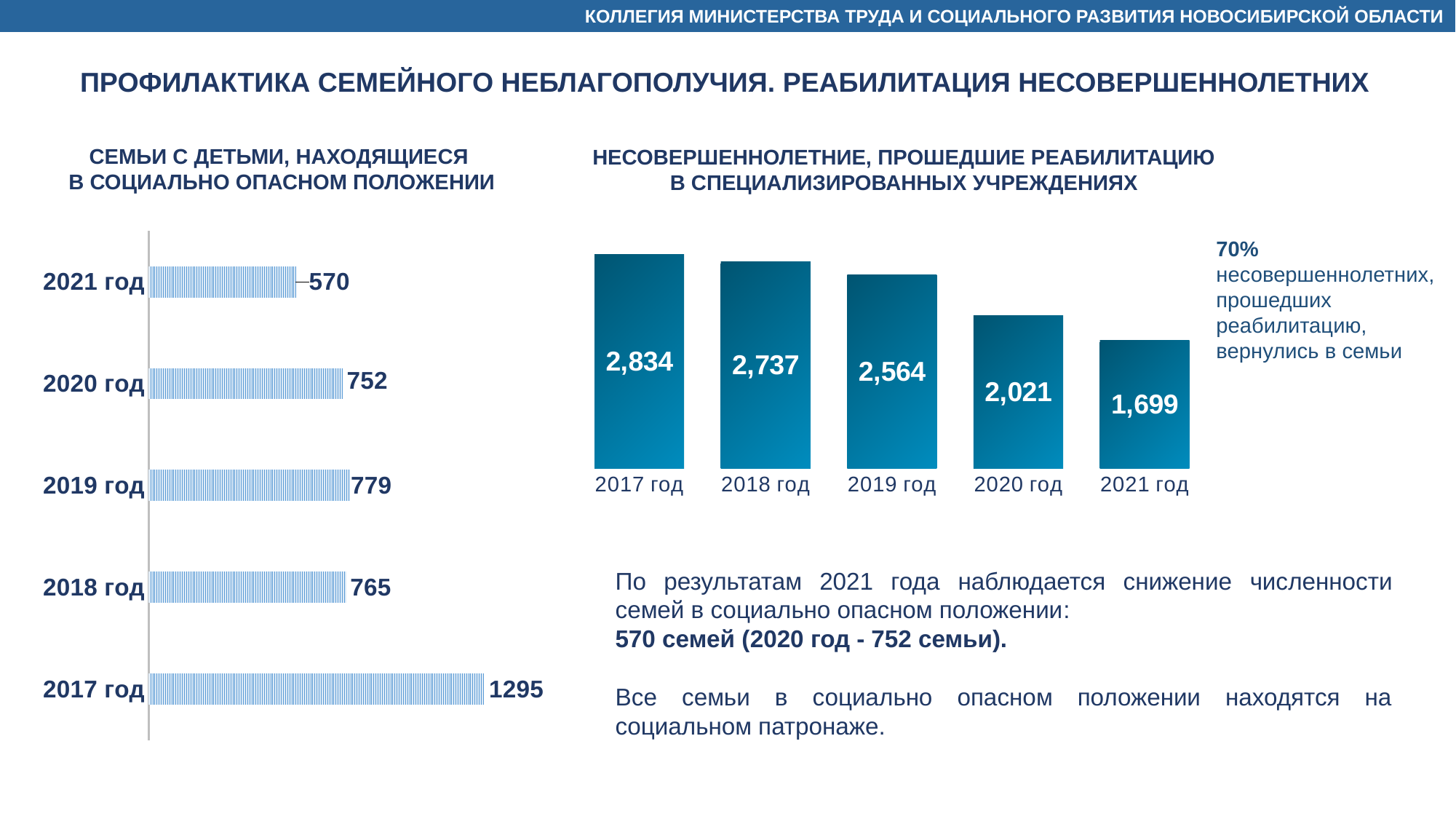
In the left chart (families with children in a socially dangerous situation), which year has the highest value? 2017 год In the left chart (families with children in a socially dangerous situation), which year has the lowest value? 2021 год In the left chart (families with children in a socially dangerous situation), what is the value for 2017 год? 1295 In the left chart (families with children in a socially dangerous situation), what is the value for 2021 год? 570 In the right chart (minors who underwent rehabilitation in specialized institutions), what is the value for 2021 год? 1,699 In the right chart (minors who underwent rehabilitation in specialized institutions), what is the value for 2019 год? 2,564 In the left chart (families with children in a socially dangerous situation), how many years are shown? 5 What kind of chart is the right chart (minors who underwent rehabilitation in specialized institutions)? bar chart In the right chart (minors who underwent rehabilitation in specialized institutions), what is the difference between the values for 2017 год and 2018 год? 97 In the left chart (families with children in a socially dangerous situation), what is the difference between the values for 2020 год and 2021 год? 182 In the right chart (minors who underwent rehabilitation in specialized institutions), which year has the highest value? 2017 год In the right chart (minors who underwent rehabilitation in specialized institutions), do the values rise or fall from 2017 год to 2021 год? fall